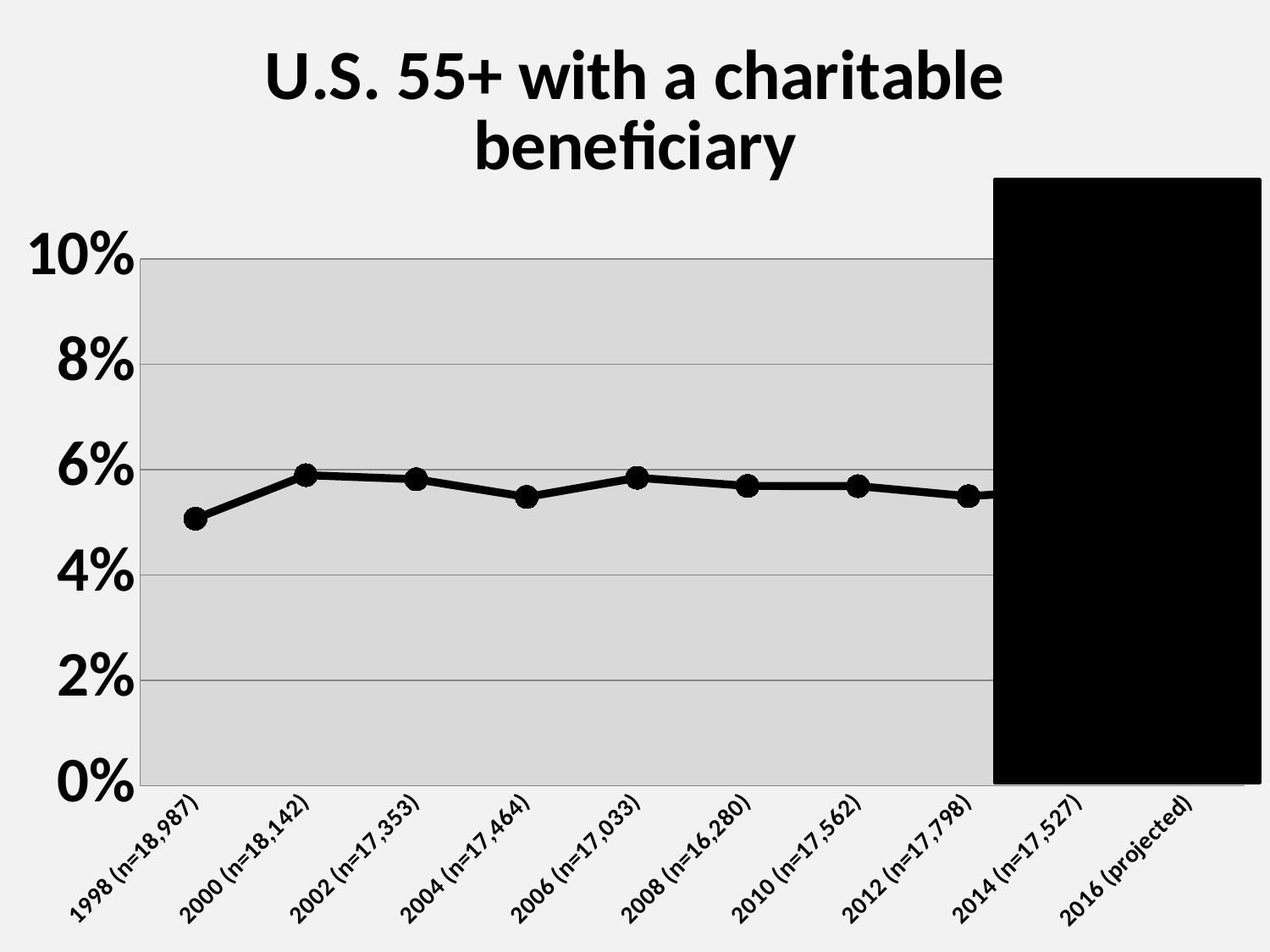
Is the value for 1998 (n=18,987) greater or less than 4%? greater Among the visible points, which year has the lowest value? 1998 (n=18,987) Is the value for 1998 (n=18,987) greater or less than 6%? less How many categories are labelled along the x axis? 10 Is the value for 2004 (n=17,464) greater or less than 6%? less Which is larger, the value for 1998 (n=18,987) or the value for 2000 (n=18,142)? 2000 (n=18,142) Does the value rise or fall from 1998 to 2000? rise What is the title of the chart? U.S. 55+ with a charitable beneficiary Which is larger, the value for 2004 (n=17,464) or the value for 2006 (n=17,033)? 2006 (n=17,033) What kind of chart is shown on the slide? line chart